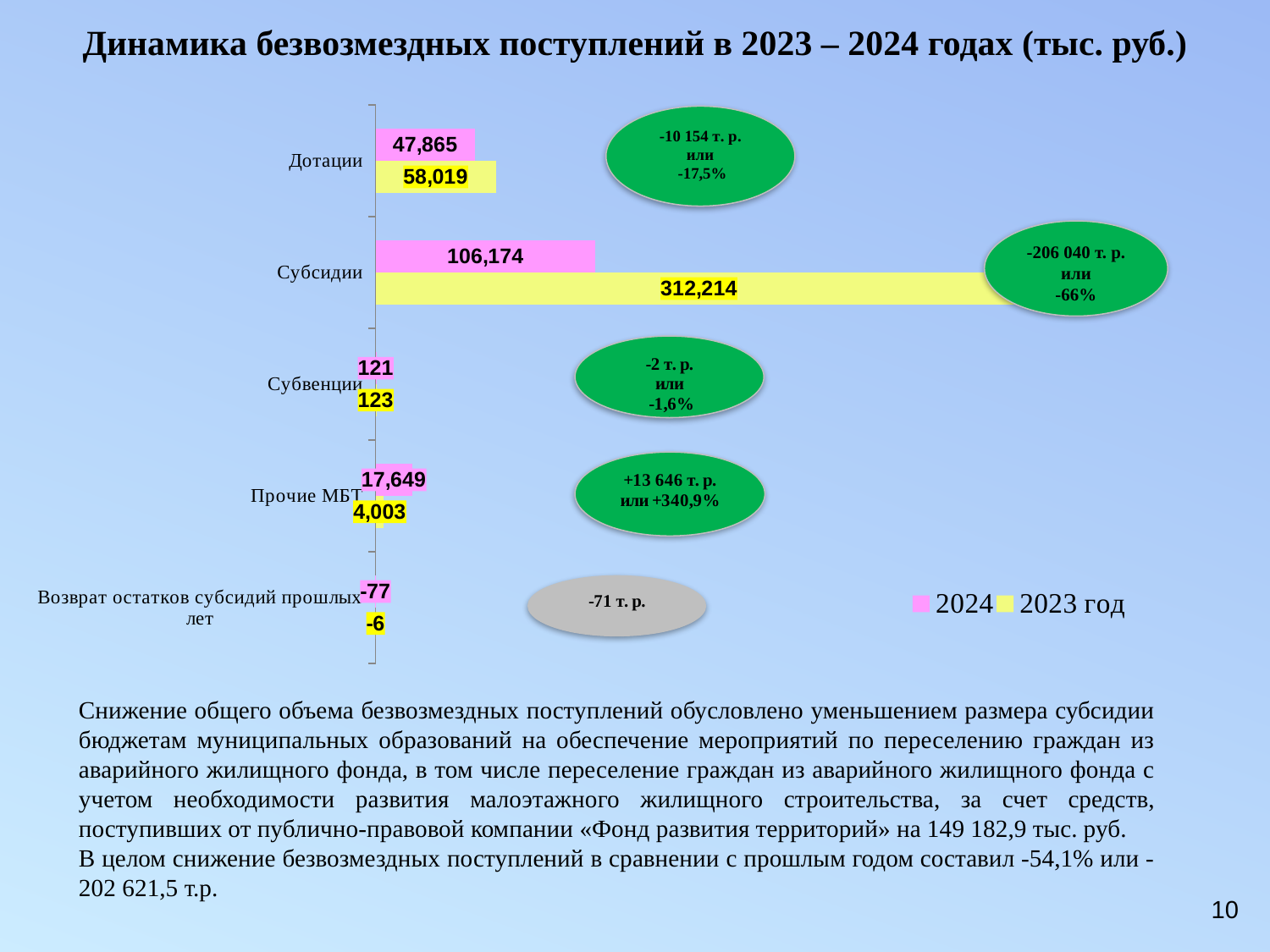
What is the value for Дотации in 2024? 47,865 Which category has the lowest value in the 2024 series? Возврат остатков субсидий прошлых лет How many series does the legend list? 2 What is the value for Возврат остатков субсидий прошлых лет in 2023? -6 What kind of chart is shown on the slide? Bar chart Which category has the highest value in the 2023 series? Субсидии What is the value for Субсидии in 2023? 312,214 What is the value for Прочие МБТ in 2024? 17,649 What is the difference between the 2023 and 2024 values for Дотации? 10,154 Which colour represents the 2024 series in the legend? Pink How many categories are shown on the chart? 5 Which is larger for Прочие МБТ: the 2024 value or the 2023 value? 2024